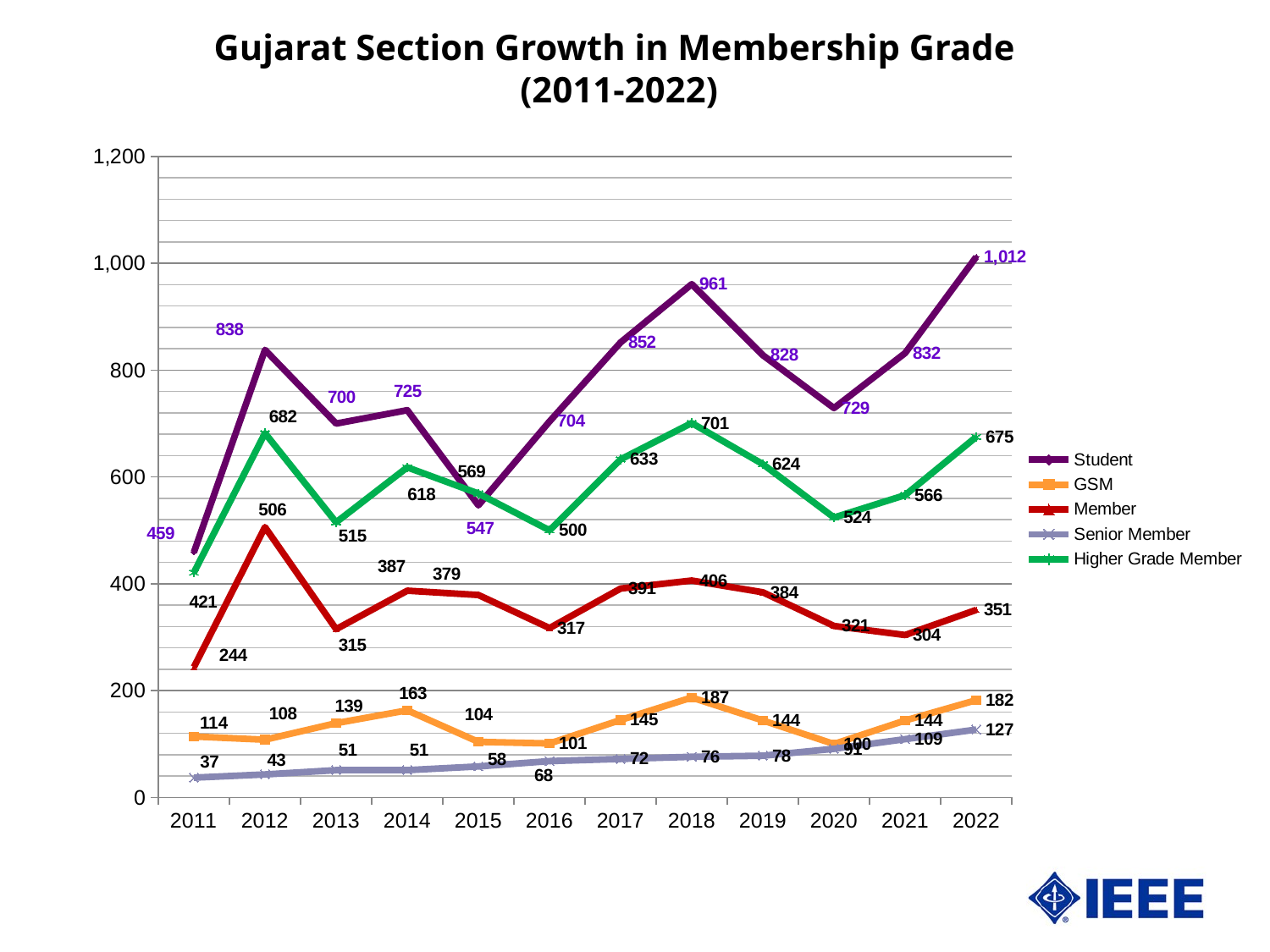
What is the value for Higher Grade Member in 2011? 421 Which year has the larger Higher Grade Member value, 2012 or 2014? 2012 How many years are plotted along the x axis? 12 What kind of chart is shown on the slide? Line chart In which year is the Member value lowest? 2011 In which year is the Student value highest? 2022 What is the value for Student in 2022? 1,012 What is the value for Member in 2018? 406 Do the Senior Member values rise or fall from 2011 to 2022? Rise How many series does the legend list? 5 What is the value for GSM in 2018? 187 What is the difference between the Student values in 2018 and 2017? 109